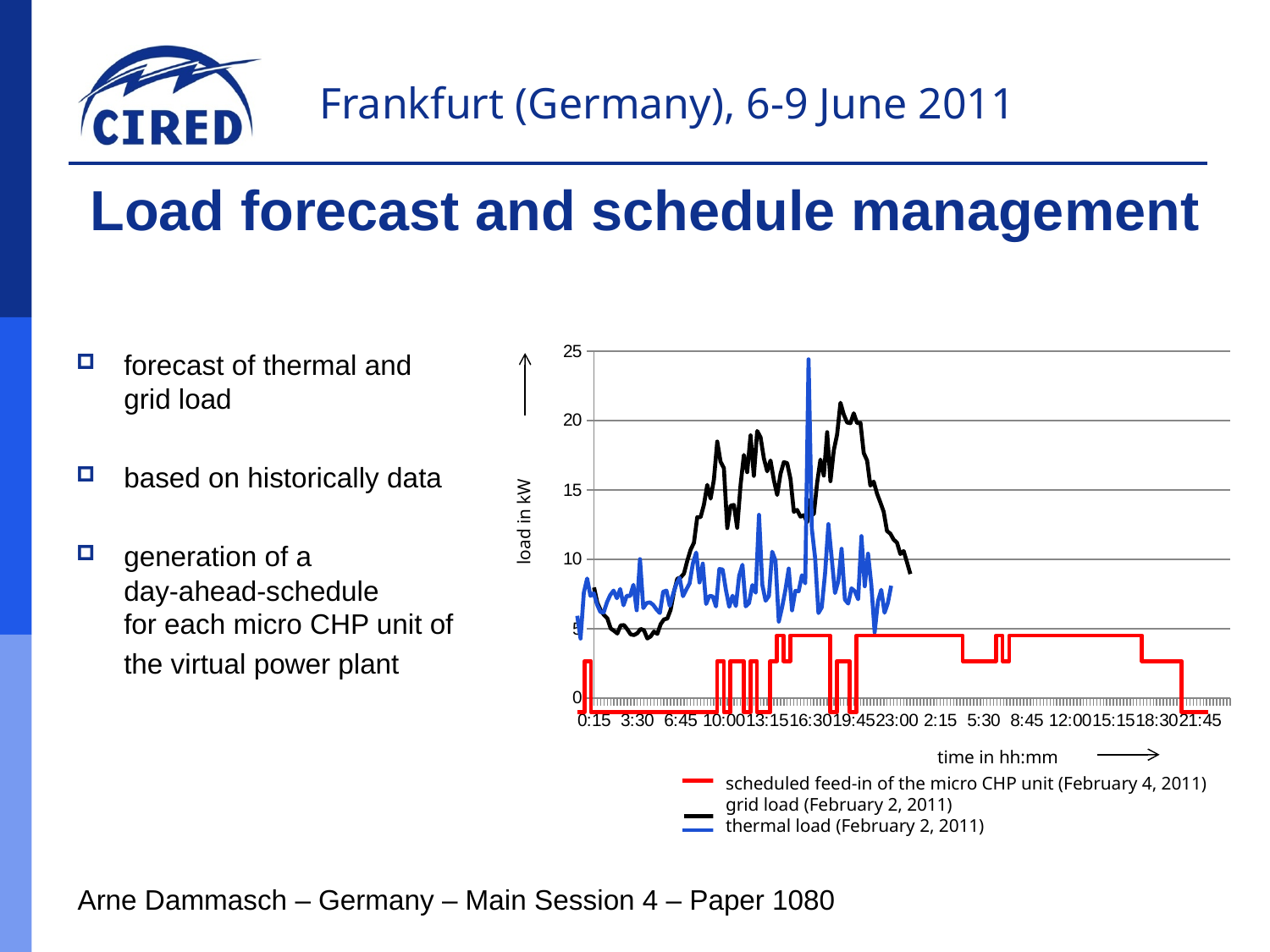
What kind of chart is shown on the slide? line chart Is the highest value of the grid load series greater or less than 20? greater What is the label of the vertical axis of the chart? load in kW Is the grid load at 3:30 greater or less than 10? less Does the grid load rise or fall between 19:45 and 23:00? fall Does the grid load rise or fall between 3:30 and 10:00? rise Which series reaches the highest peak value in the chart, grid load or thermal load? thermal load Is the highest value of the thermal load series greater or less than 20? greater What is the highest value shown on the vertical axis of the chart? 25 How many series does the chart legend list? 3 Which series is drawn in red in the chart? scheduled feed-in of the micro CHP unit (February 4, 2011)